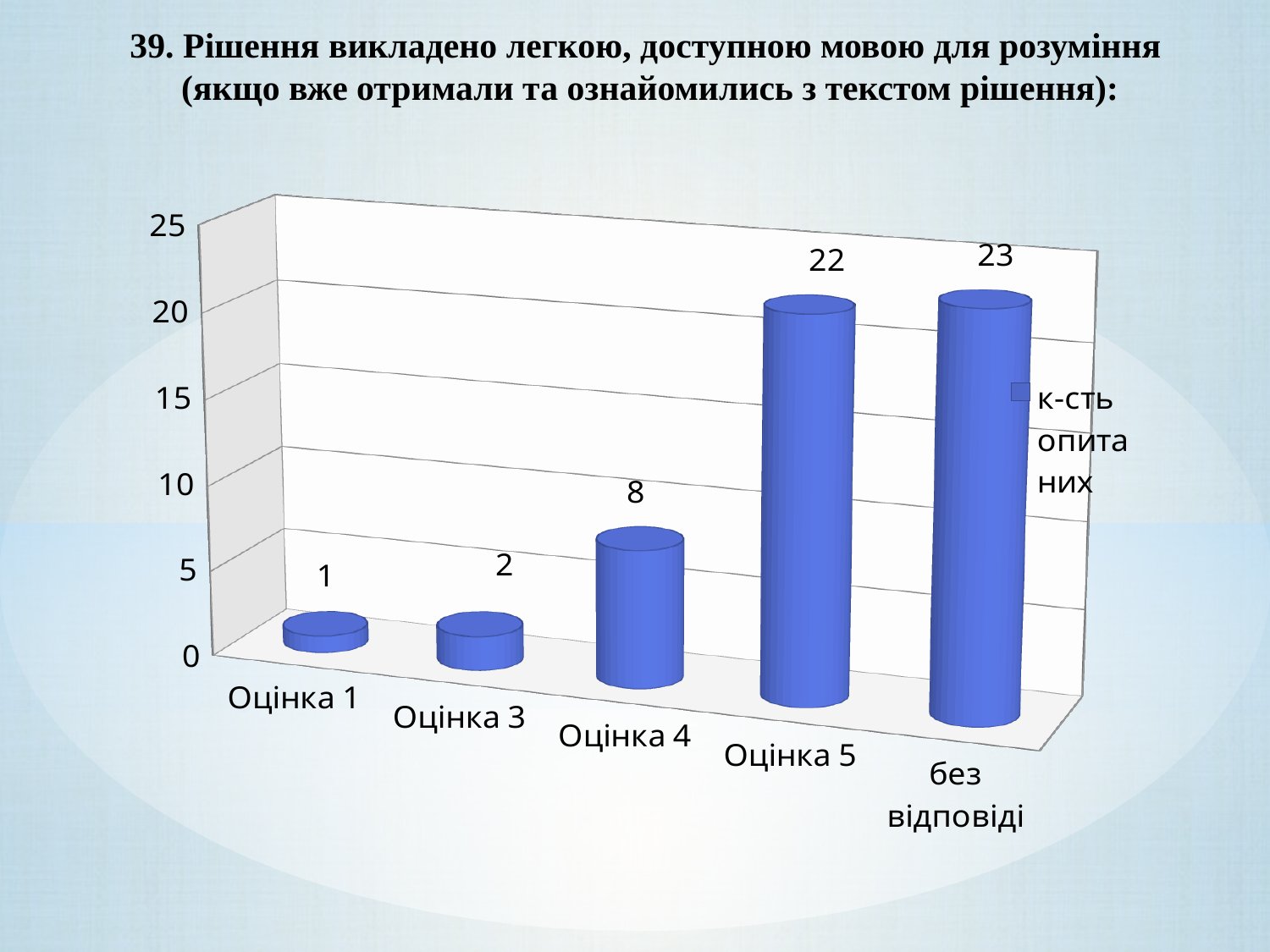
Which category has the lowest value? Оцінка 1 What is the value for Оцінка 4? 8 How many series does the legend list? 1 What is the legend entry for the series? к-сть опитаних How many categories are shown on the x axis? 5 What is the value for Оцінка 1? 1 What is the value for Оцінка 5? 22 What kind of chart is shown on the slide? bar chart Which category has the highest value? без відповіді What is the value for без відповіді? 23 Which is larger, the value for Оцінка 3 or the value for Оцінка 4? Оцінка 4 What is the difference between the values for Оцінка 5 and Оцінка 4? 14